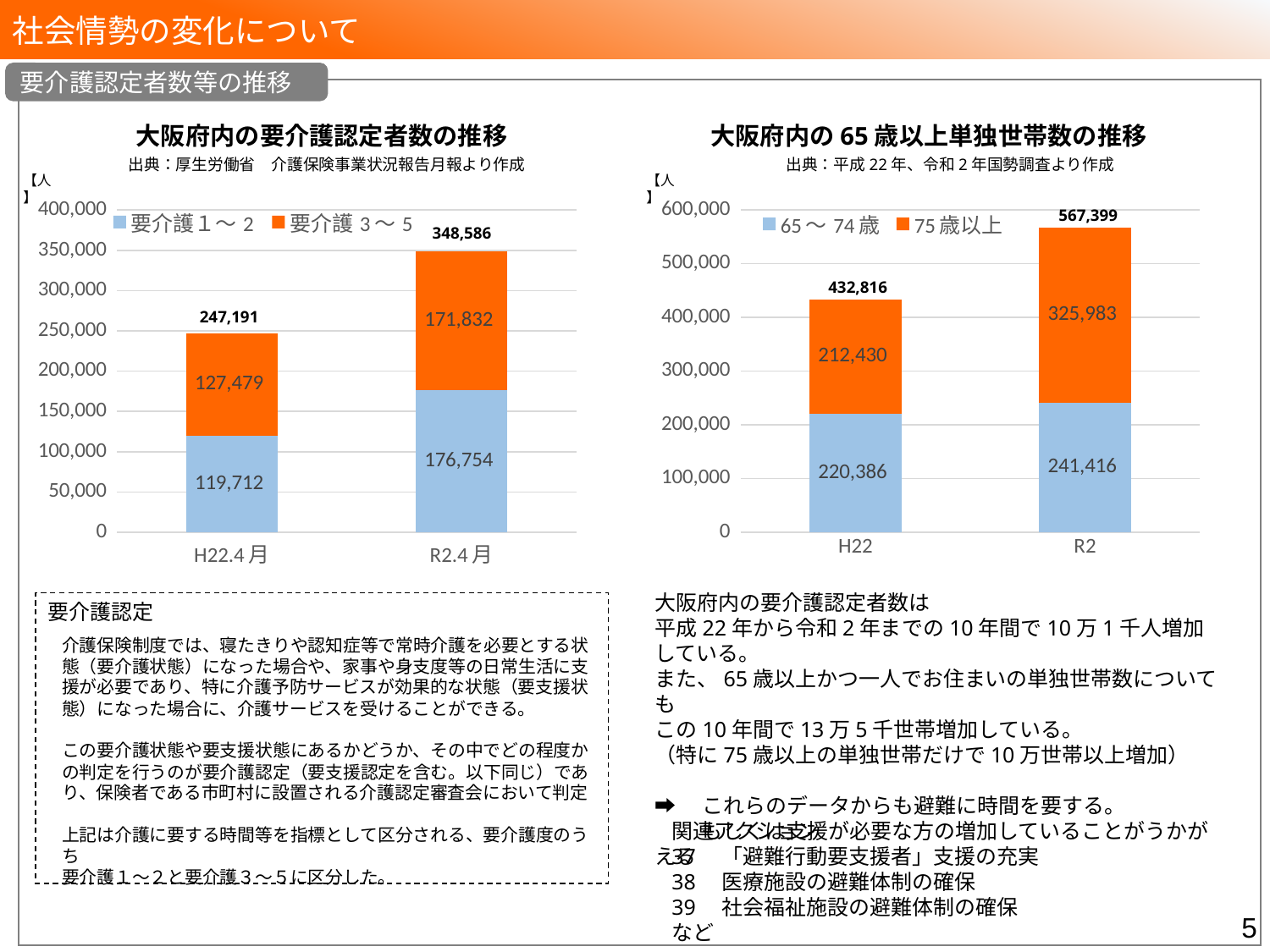
In the chart titled 大阪府内の要介護認定者数の推移, what is the total of the stacked bar for R2.4月? 348,586 What kind of chart is 大阪府内の65歳以上単独世帯数の推移? stacked bar chart In the chart titled 大阪府内の要介護認定者数の推移, what is the value for 要介護３～５ at R2.4月? 171,832 In the chart titled 大阪府内の要介護認定者数の推移, what is the difference between the 要介護３～５ values for R2.4月 and H22.4月? 44,353 In the chart titled 大阪府内の65歳以上単独世帯数の推移, what is the difference between the totals for R2 and H22? 134,583 In the chart titled 大阪府内の要介護認定者数の推移, what is the value for 要介護１～２ at H22.4月? 119,712 In the chart titled 大阪府内の65歳以上単独世帯数の推移, what is the value for 75歳以上 at R2? 325,983 In the chart titled 大阪府内の要介護認定者数の推移, does the total rise or fall from H22.4月 to R2.4月? rise In the chart titled 大阪府内の65歳以上単独世帯数の推移, which is larger at R2: 65～74歳 or 75歳以上? 75歳以上 In the chart titled 大阪府内の65歳以上単独世帯数の推移, what is the value for 65～74歳 at H22? 220,386 In the chart titled 大阪府内の要介護認定者数の推移, how many series does the legend list? 2 In the chart titled 大阪府内の65歳以上単独世帯数の推移, what is the total of the stacked bar for H22? 432,816